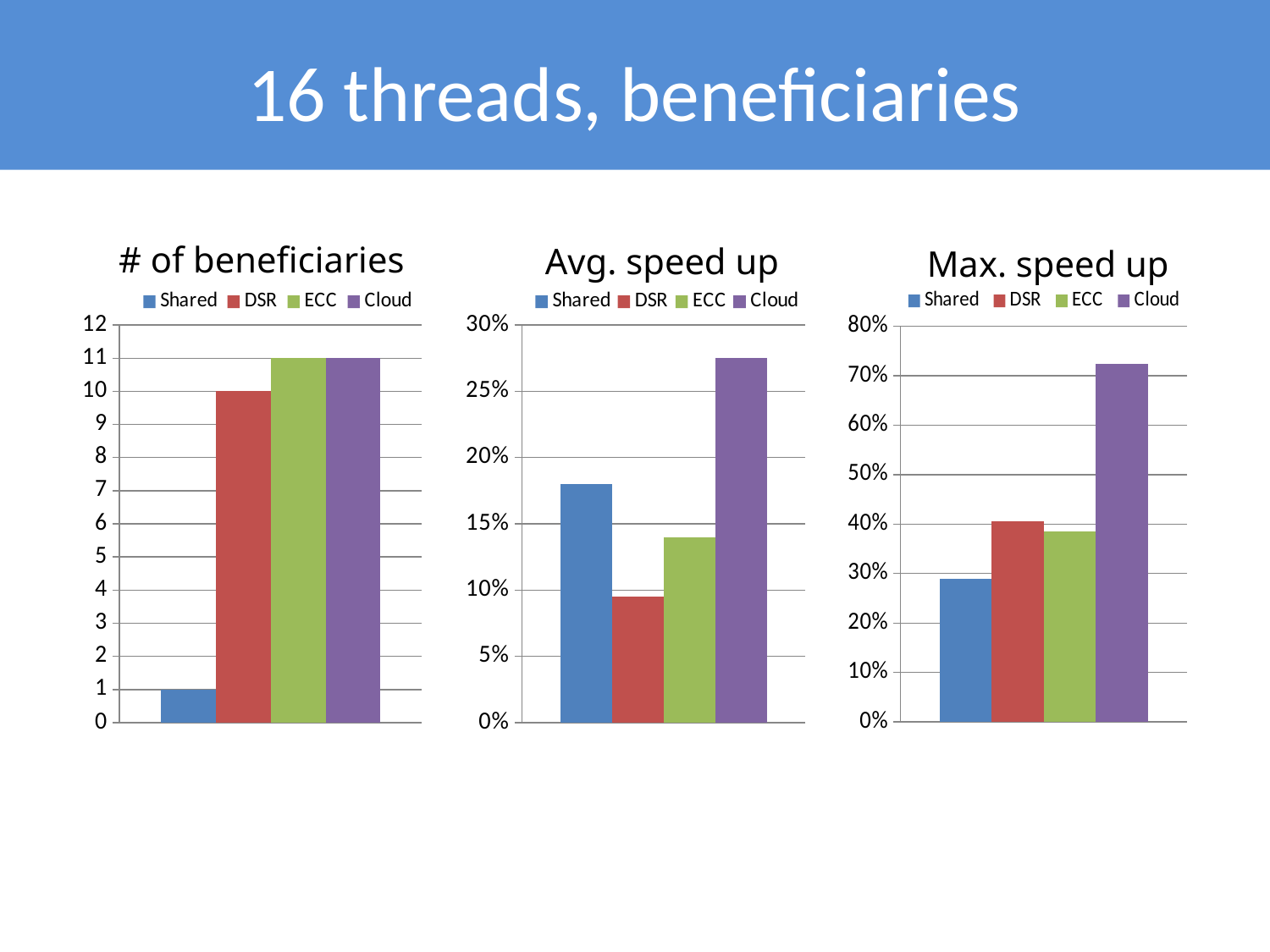
In the 'Max. speed up' chart, which is larger, the value for Shared or the value for DSR? DSR In the '# of beneficiaries' chart, which series has the lowest value? Shared In the 'Avg. speed up' chart, which series has the highest value? Cloud In the 'Avg. speed up' chart, is the value for Shared greater or less than 15%? greater In the 'Max. speed up' chart, is the value for Cloud greater or less than 70%? greater In the '# of beneficiaries' chart, what is the value for Shared? 1 What kind of chart is the 'Avg. speed up' chart? Bar chart In the '# of beneficiaries' chart, what is the value for Cloud? 11 How many series does the legend of the 'Max. speed up' chart list? 4 In the '# of beneficiaries' chart, what is the difference between the values for DSR and Shared? 9 In the '# of beneficiaries' chart, what is the value for DSR? 10